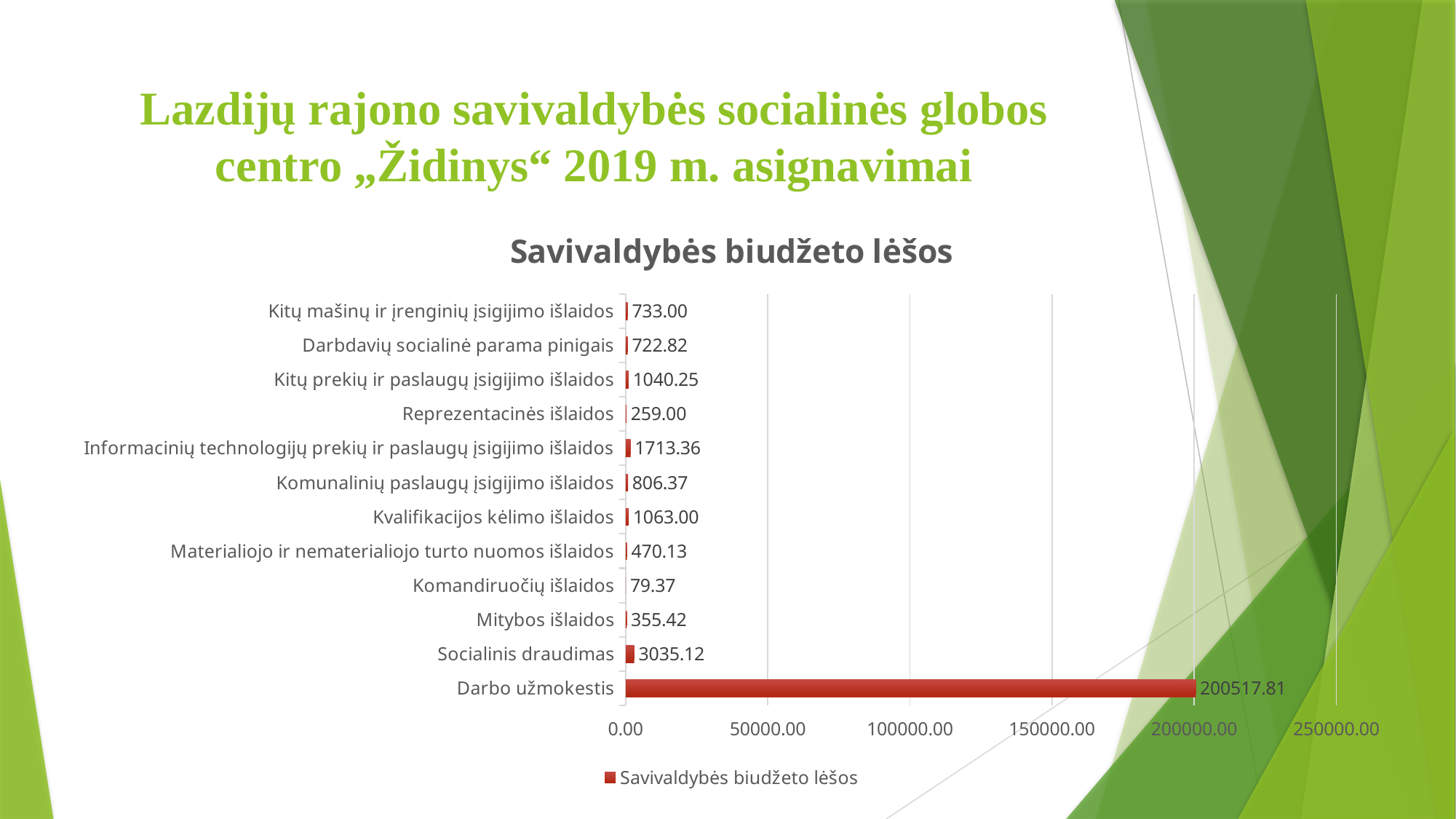
What is the value for Komandiruočių išlaidos? 79.37 What is the value for Informacinių technologijų prekių ir paslaugų įsigijimo išlaidos? 1713.36 What is the difference between the values for Socialinis draudimas and Informacinių technologijų prekių ir paslaugų įsigijimo išlaidos? 1321.76 Which category has the highest value? Darbo užmokestis What is the value for Darbo užmokestis? 200517.81 What is the title of the chart? Savivaldybės biudžeto lėšos What is the value for Socialinis draudimas? 3035.12 Which category has the lowest value? Komandiruočių išlaidos Which is larger, the value for Socialinis draudimas or the value for Mitybos išlaidos? Socialinis draudimas Is the value for Darbo užmokestis greater or less than 250000.00? less What kind of chart is shown on the slide? bar chart How many categories are shown in the chart? 12